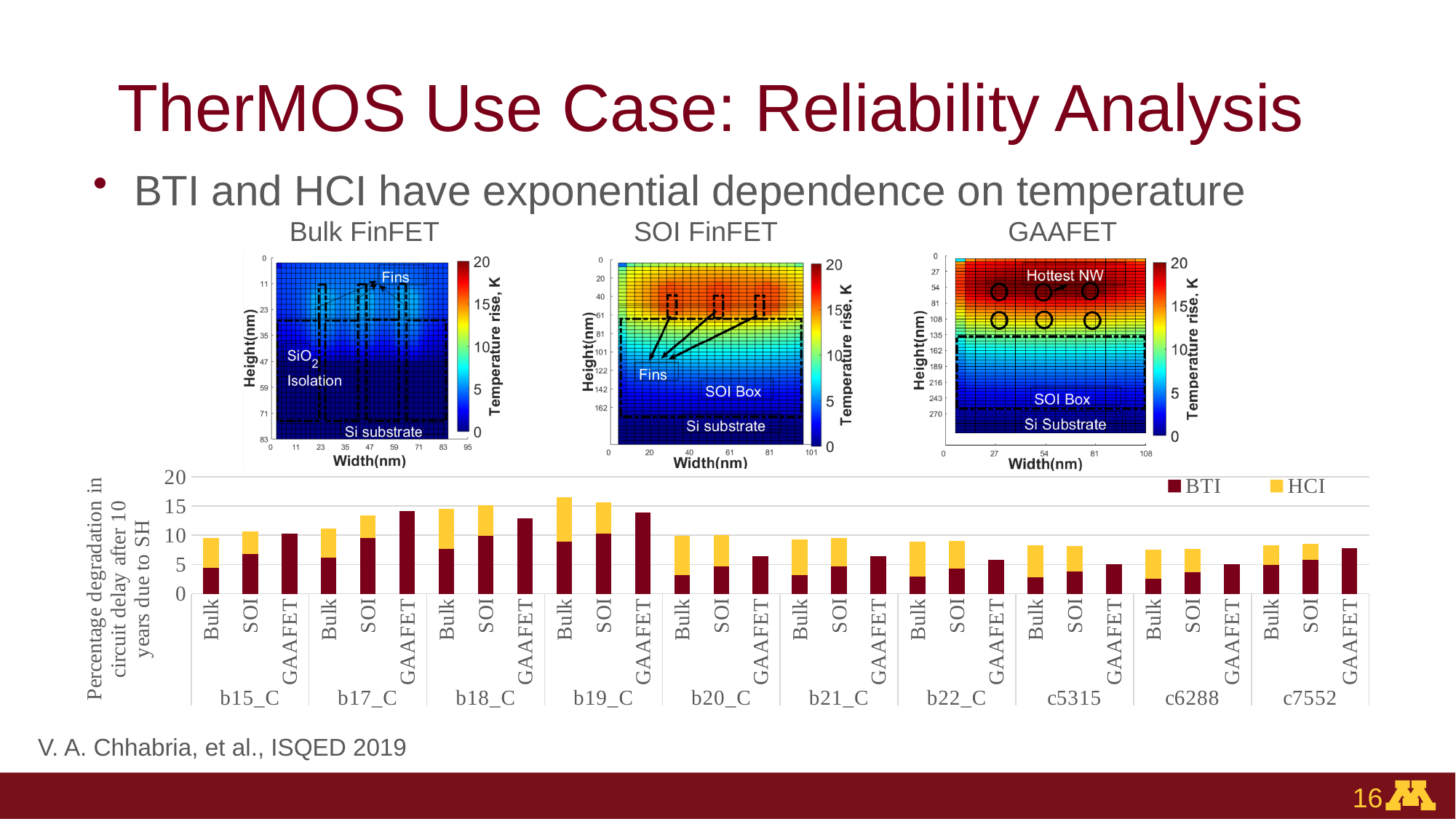
In the bottom bar chart, which bar has the highest total percentage degradation? b19_C Bulk In the bottom bar chart, how many series does the legend list? 2 In the bottom bar chart, is the total for b19_C Bulk greater or less than 15? greater In the bottom bar chart, is the total for c6288 Bulk greater or less than 10? less In the bottom bar chart, how many bars are plotted in total? 30 What kind of chart is the chart at the bottom of the slide? Stacked bar chart In the bottom bar chart, is the total for b17_C GAAFET greater or less than 10? greater In the bottom bar chart, how many circuit groups (e.g. b15_C, c7552) are shown on the x axis? 10 In the bottom bar chart, which has the larger total: b18_C SOI or b21_C SOI? b18_C SOI In the bottom bar chart, which series is shown in yellow? HCI What is the maximum value on the colour bar of the three temperature-rise heatmaps? 20